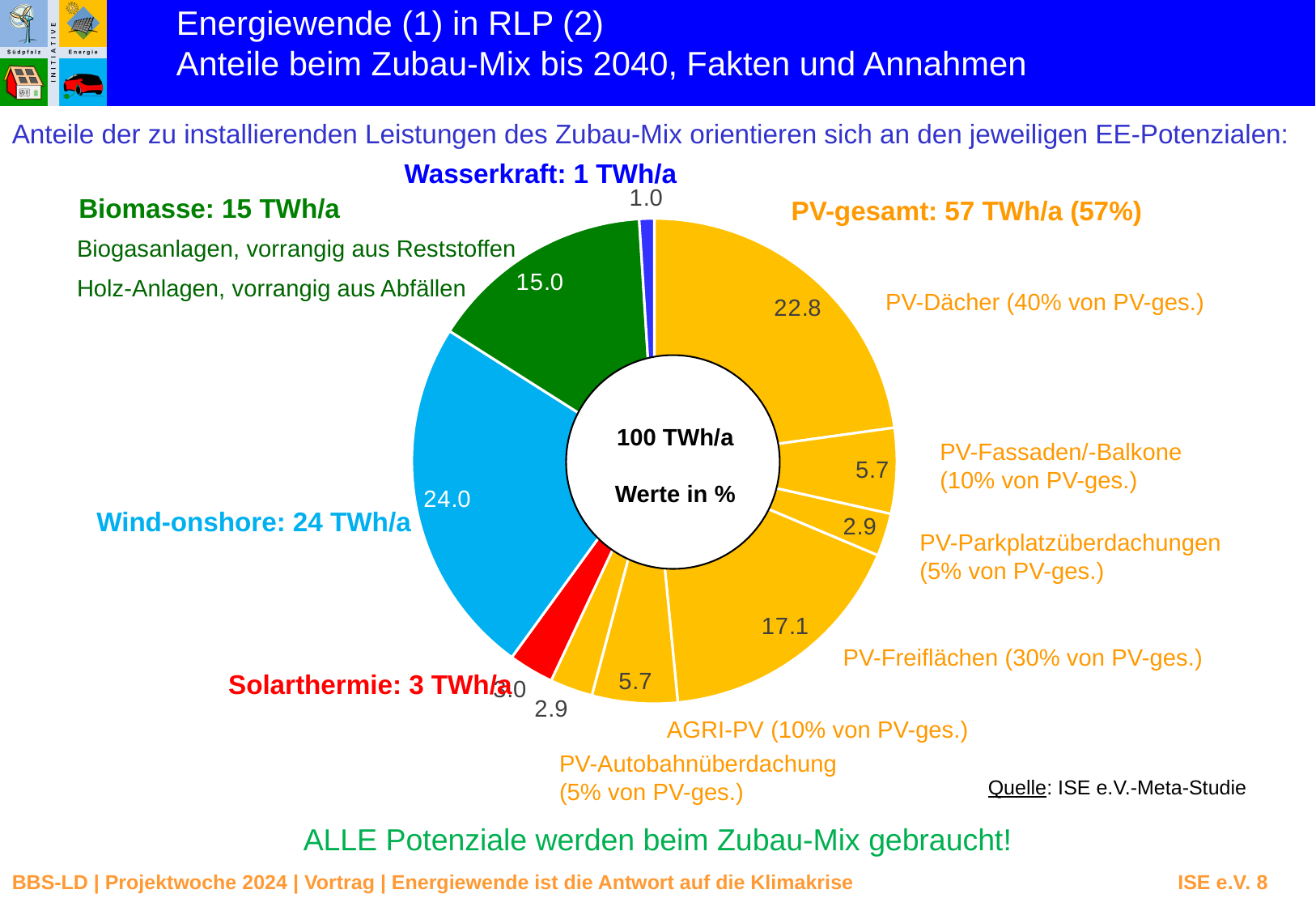
What kind of chart is shown on the slide? Doughnut (pie) chart What value is shown for the PV-Freiflächen slice? 17.1 What value is shown for the Wind-onshore slice? 24.0 What value is shown for the Biomasse slice? 15.0 What text is shown in the centre of the doughnut chart? 100 TWh/a, Werte in % Which slice has the smallest value? Wasserkraft What value is shown for the Wasserkraft slice? 1.0 How many slices does the chart have? 10 Which slice has the largest value? Wind-onshore What is the difference between the Wind-onshore value and the PV-Dächer value? 1.2 Which is larger, the PV-Freiflächen slice or the Biomasse slice? PV-Freiflächen What value is shown for the PV-Dächer slice? 22.8